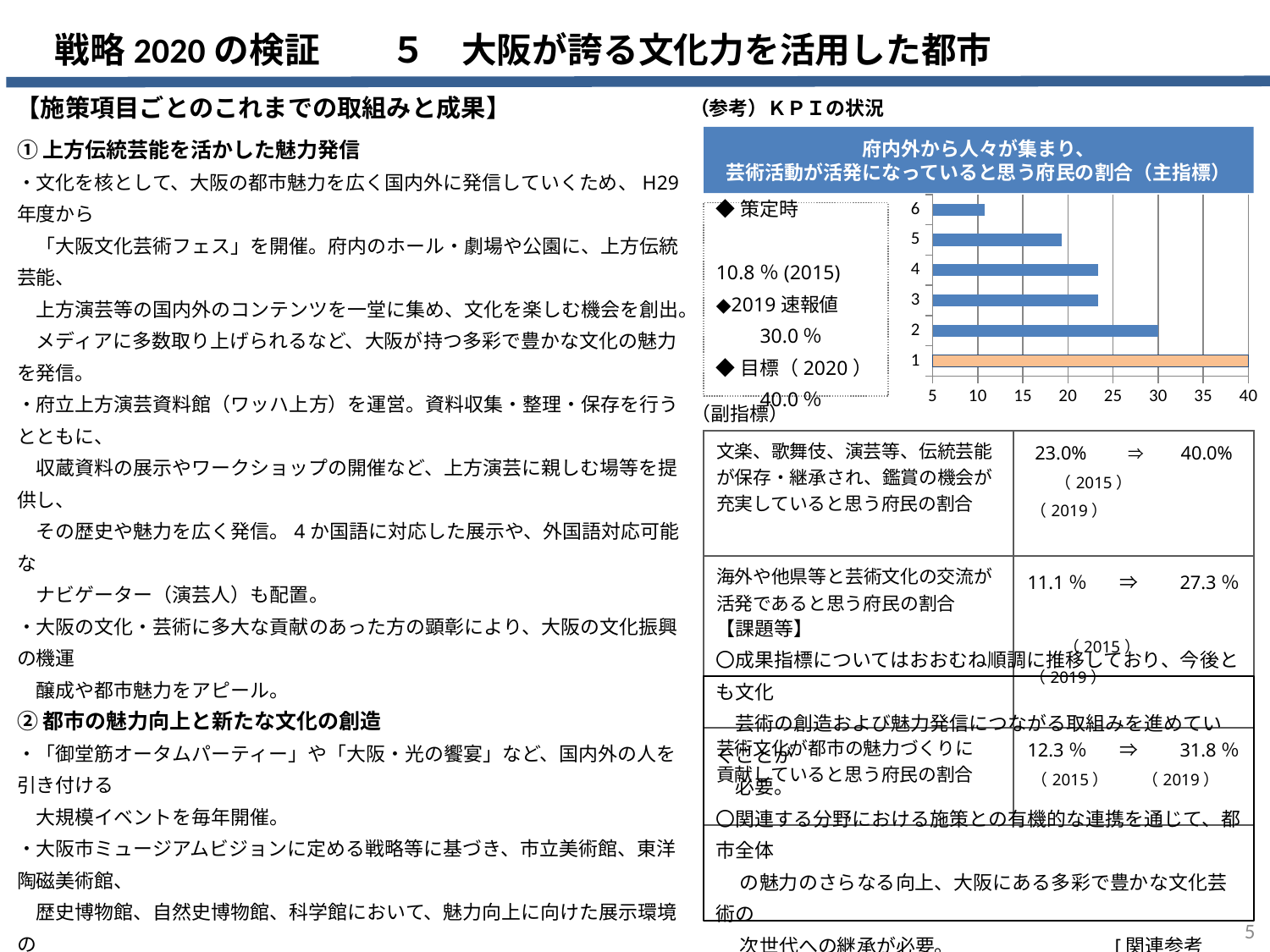
Which category's bar is drawn in orange rather than blue? 1 Which category has the longest bar in the chart? 1 Which bar is longer, category 4 or category 6? 4 Which category has the shortest bar in the chart? 6 What value does the bar for category 1 reach on the x axis? 40 What is the highest value shown on the x axis of the chart? 40 Is the value for category 5 greater or less than 15? greater Is the value for category 6 greater or less than 15? less What kind of chart is shown under the KPI heading on the right of the slide? bar chart Is the value for category 2 greater or less than 25? greater Which bar is longer, category 2 or category 5? 2 How many categories are plotted on the y axis of the bar chart? 6